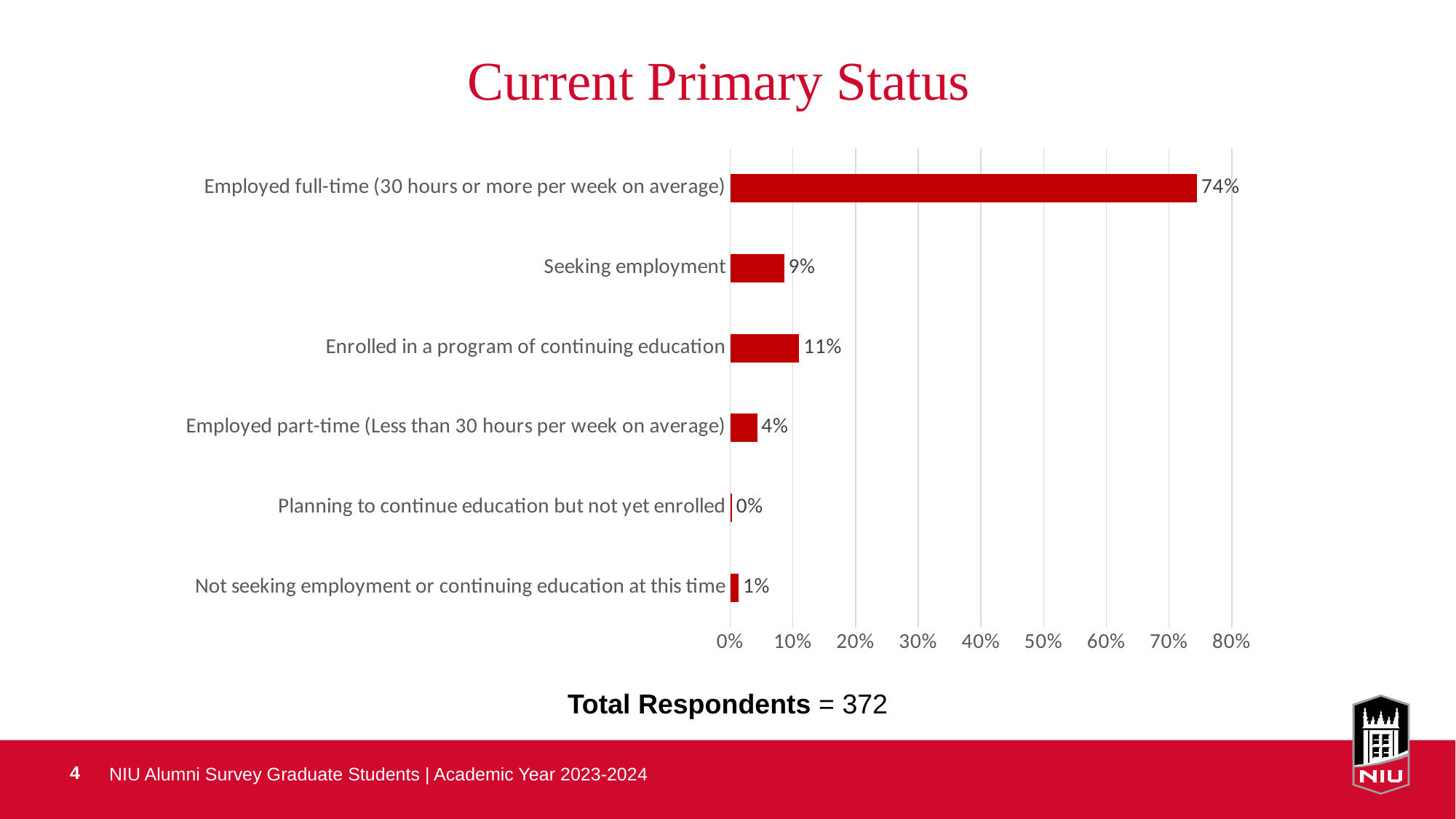
Which is larger: the percentage seeking employment or the percentage enrolled in a program of continuing education? Enrolled in a program of continuing education What percentage of respondents are seeking employment? 9% What percentage of respondents are employed part-time (less than 30 hours per week on average)? 4% Which category has the lowest percentage? Planning to continue education but not yet enrolled What kind of chart is shown on the slide? Bar chart Is the value for employed full-time greater or less than 70%? greater What percentage of respondents are enrolled in a program of continuing education? 11% What is the title of the chart? Current Primary Status How many categories are shown in the chart? 6 What is the difference in percentage points between employed full-time and enrolled in a program of continuing education? 63 What percentage of respondents are employed full-time (30 hours or more per week on average)? 74% Which category has the highest percentage? Employed full-time (30 hours or more per week on average)